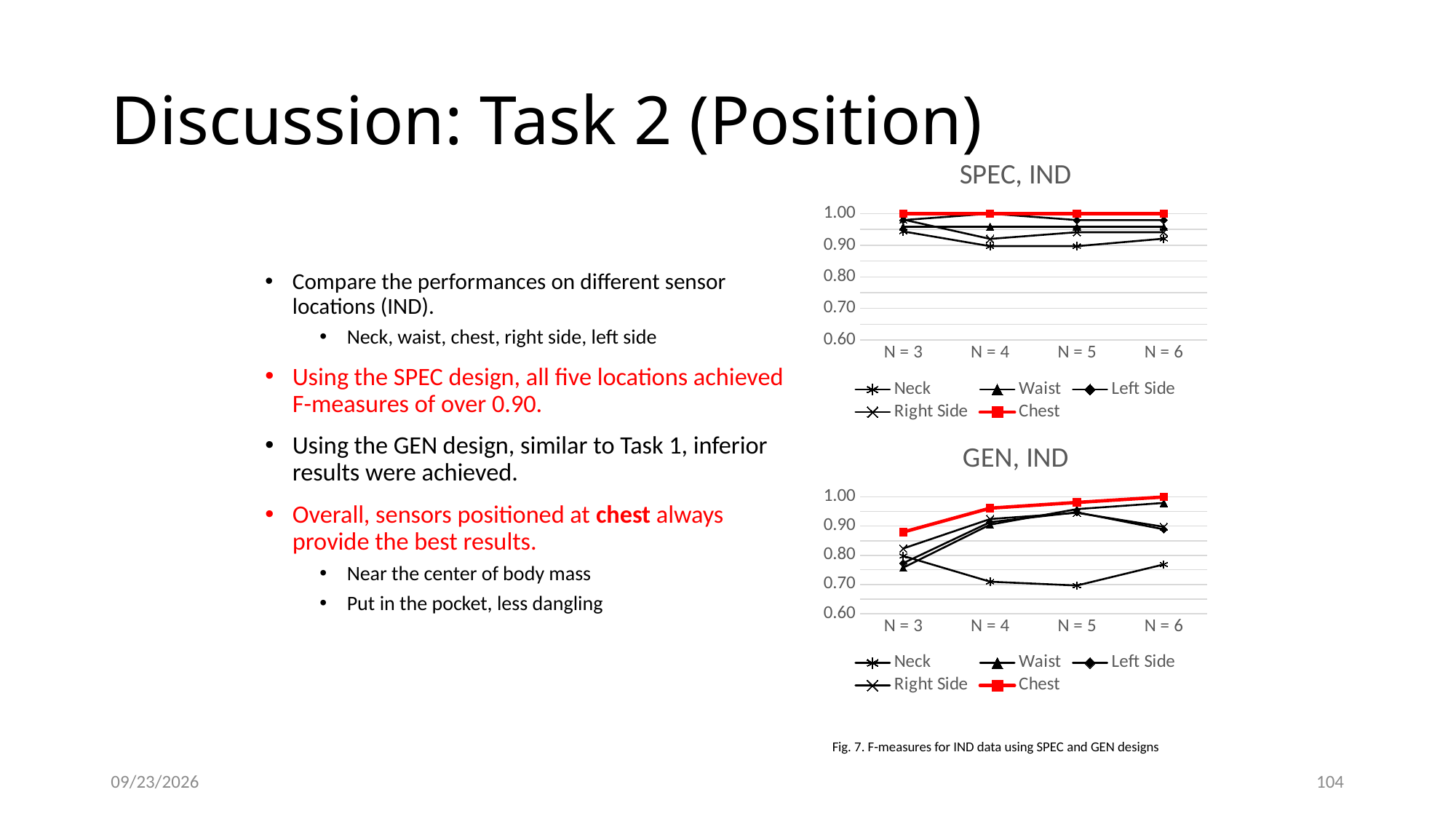
What kind of chart is the "SPEC, IND" chart? line chart In the "GEN, IND" chart, which series is drawn in red? Chest How many categories are shown on the x axis of the "SPEC, IND" chart? 4 In the "GEN, IND" chart, which is larger for Neck: the value at N = 3 or the value at N = 5? N = 3 In the "GEN, IND" chart, is the value for Chest at N = 3 greater or less than 0.80? greater In the "GEN, IND" chart, is the value for Waist at N = 3 greater or less than 0.80? less In the "GEN, IND" chart, does the Chest series rise or fall from N = 3 to N = 6? rise What is the title of the lower chart on the slide? GEN, IND In the "GEN, IND" chart, is the value for Neck at N = 6 greater or less than 0.80? less How many series does the legend of the "GEN, IND" chart list? 5 In the "GEN, IND" chart, which series has the highest value at N = 6? Chest In the "GEN, IND" chart, which series has the lowest value at N = 5? Neck